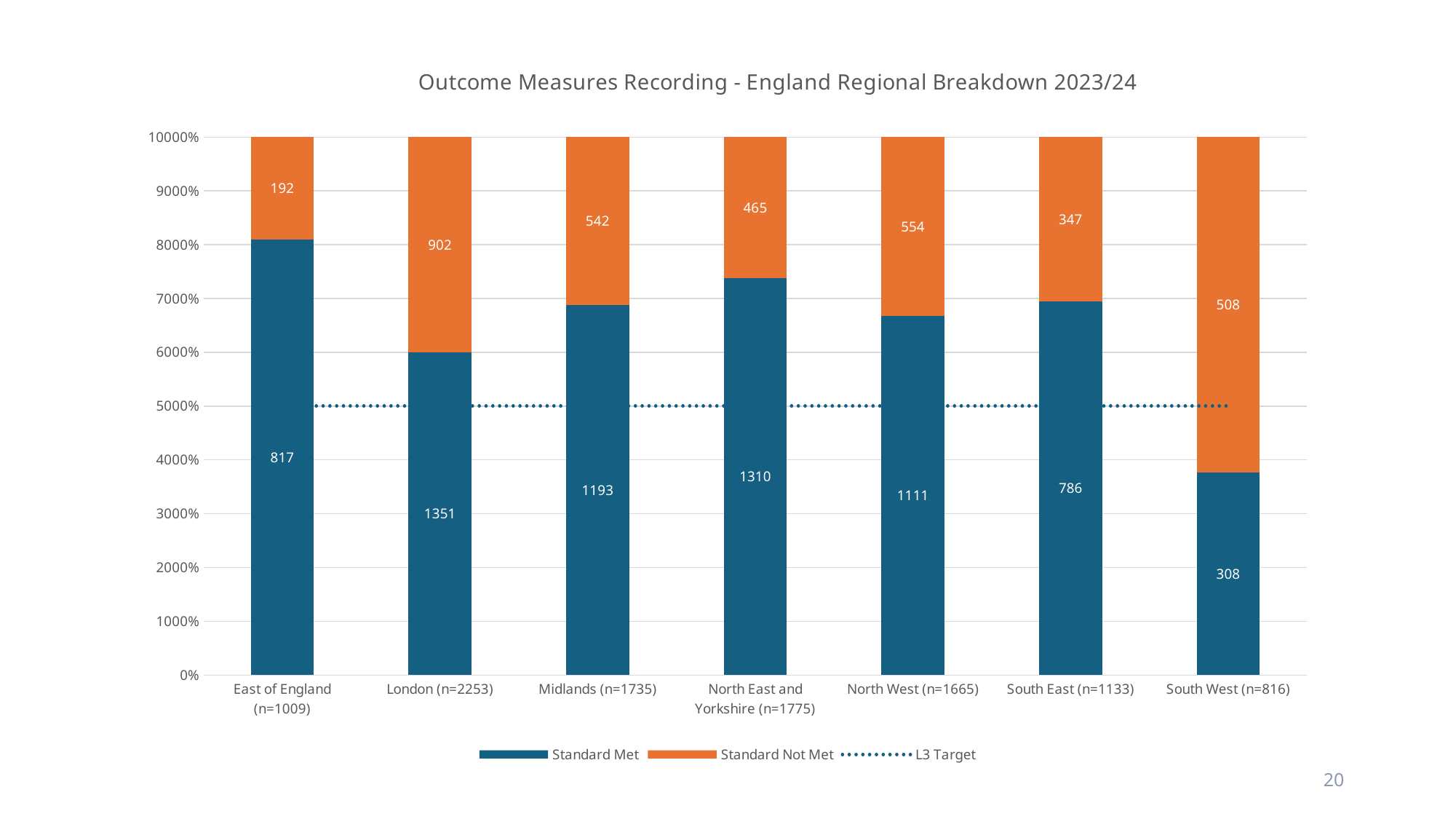
Which region has the lowest Standard Met value? South West (n=816) What is the total of the Standard Met and Standard Not Met values for East of England (n=1009)? 1009 How many regions are shown on the x axis? 7 What is the difference between the Standard Met and Standard Not Met values for London (n=2253)? 449 Which is larger: the Standard Not Met value for Midlands (n=1735) or for North West (n=1665)? North West (n=1665) How many entries does the legend list? 3 What is the Standard Not Met value for South West (n=816)? 508 Which region has the lowest Standard Not Met value? East of England (n=1009) What is the Standard Met value for London (n=2253)? 1351 What is the Standard Not Met value for East of England (n=1009)? 192 What type of chart is shown on the slide? Stacked bar chart with a dotted target line